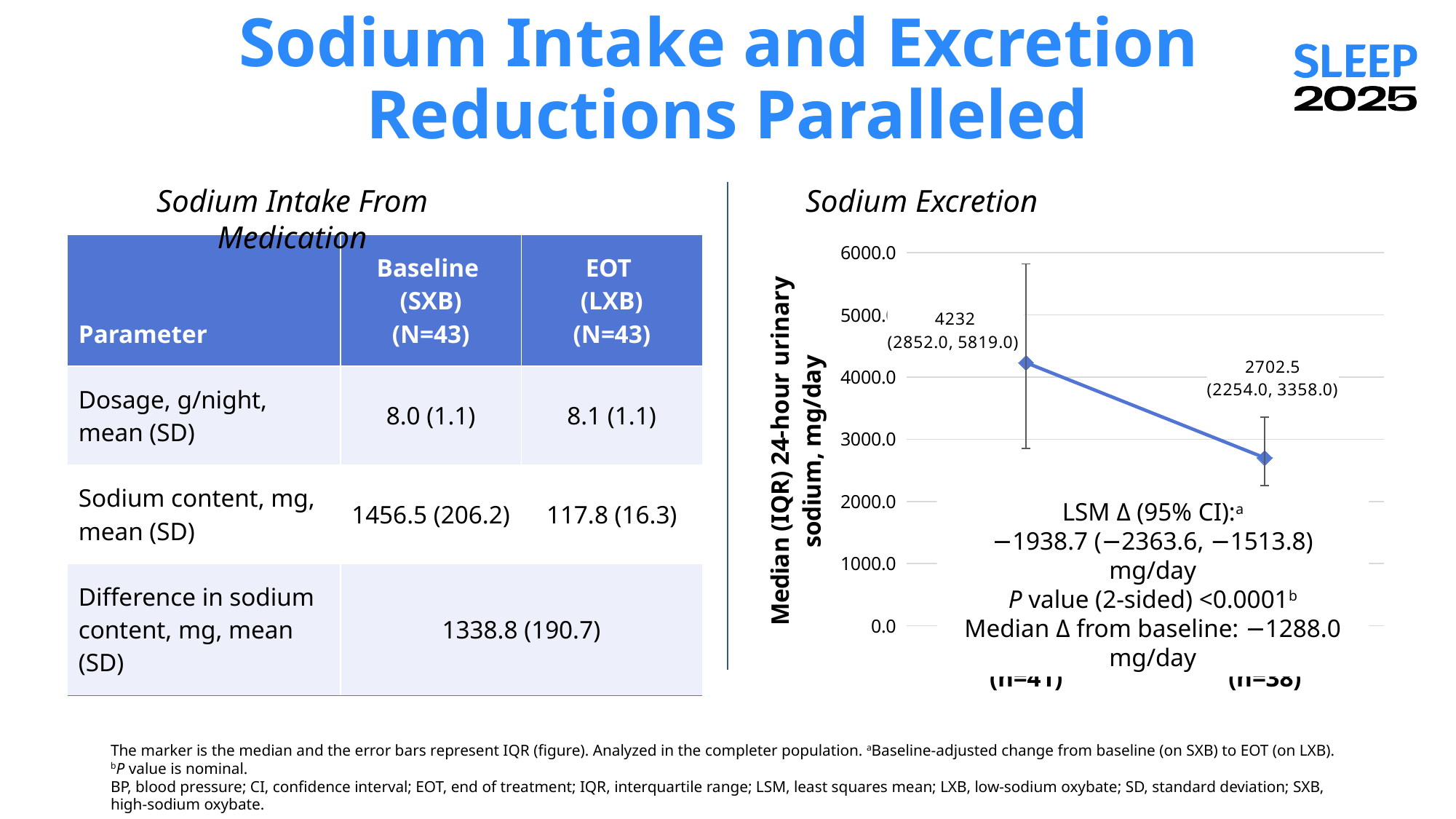
On the Sodium Excretion chart, what IQR is shown for the second (right) point? (2254.0, 3358.0) On the Sodium Excretion chart, what is the median value labelled at the second (right) point? 2702.5 On the Sodium Excretion chart, do the median values rise or fall from left to right? fall On the Sodium Excretion chart, what is the median value labelled at the first (left) point? 4232 What LSM Δ (95% CI) is annotated on the Sodium Excretion chart? −1938.7 (−2363.6, −1513.8) mg/day How many data points are plotted on the Sodium Excretion chart? 2 On the Sodium Excretion chart, what is the difference between the median values of the first and second points? 1529.5 On the Sodium Excretion chart, which point has the higher median value, the first (left) or the second (right)? the first (left) point On the Sodium Excretion chart, what IQR is shown for the first (left) point? (2852.0, 5819.0) On the Sodium Excretion chart, is the median value of the second (right) point greater or less than 3000.0? less What is the y-axis title of the Sodium Excretion chart? Median (IQR) 24-hour urinary sodium, mg/day What kind of chart is the Sodium Excretion chart? line chart